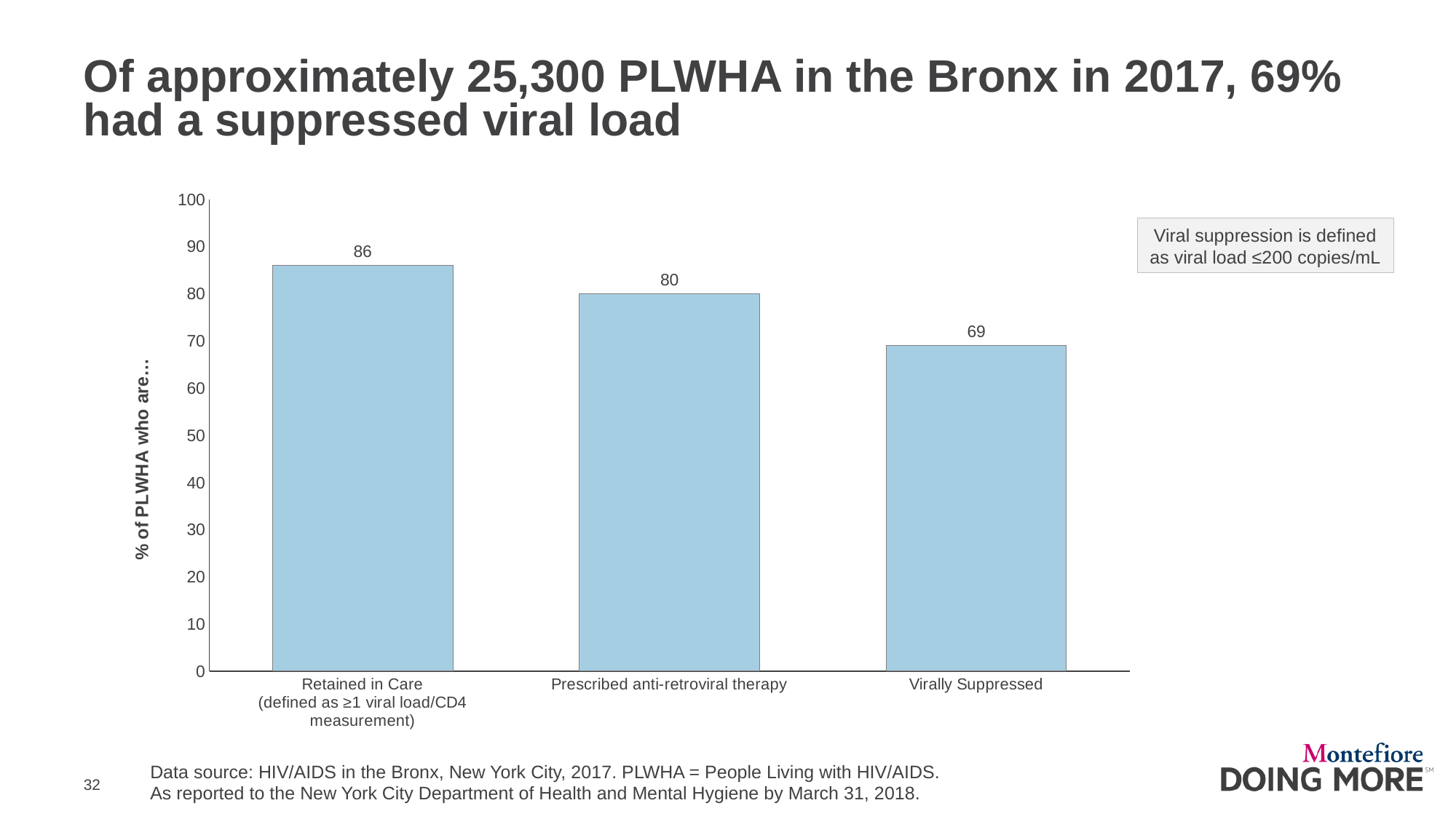
Do the values rise or fall from left to right across the categories? fall What is the value for Prescribed anti-retroviral therapy? 80 What is the value for Retained in Care? 86 Which is larger, the value for Prescribed anti-retroviral therapy or the value for Virally Suppressed? Prescribed anti-retroviral therapy What is the difference between the values for Retained in Care and Virally Suppressed? 17 Which category has the lowest value? Virally Suppressed Is the value for Virally Suppressed greater or less than 70? less What is the difference between the values for Prescribed anti-retroviral therapy and Virally Suppressed? 11 What is the value for Virally Suppressed? 69 What kind of chart is shown on the slide? bar chart Which category has the highest value? Retained in Care How many categories are shown on the chart? 3